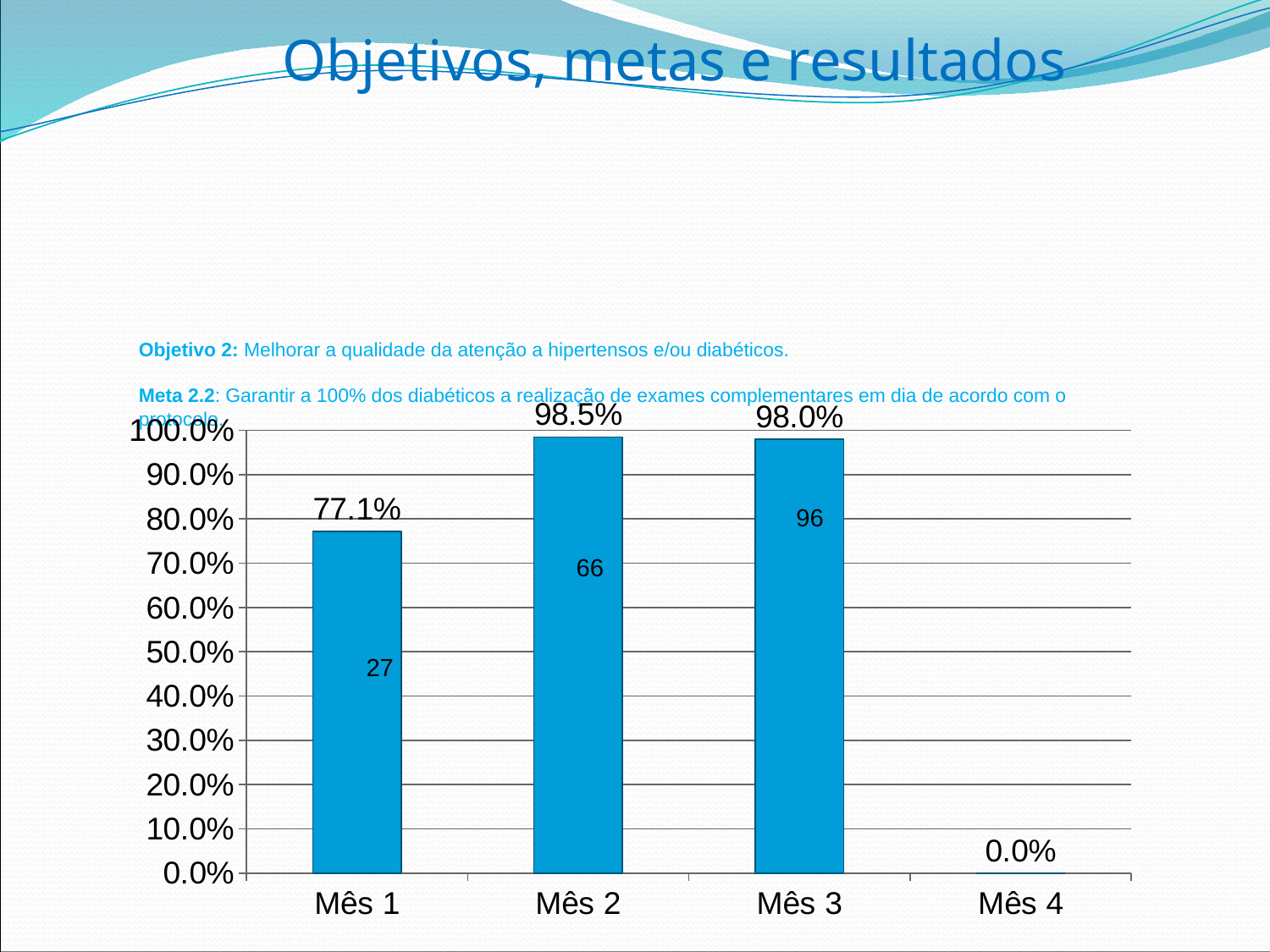
Which is larger, the value for Mês 1 or the value for Mês 3? Mês 3 What number is printed inside the bar for Mês 3? 96 Which month has the lowest value? Mês 4 What is the difference between the values for Mês 2 and Mês 1? 21.4% How many months are shown on the x axis? 4 What is the value for Mês 4? 0.0% What is the value for Mês 1? 77.1% What is the value for Mês 2? 98.5% What kind of chart is shown on the slide? Bar chart What number is printed inside the bar for Mês 1? 27 What is the value for Mês 3? 98.0% Which month has the highest value? Mês 2